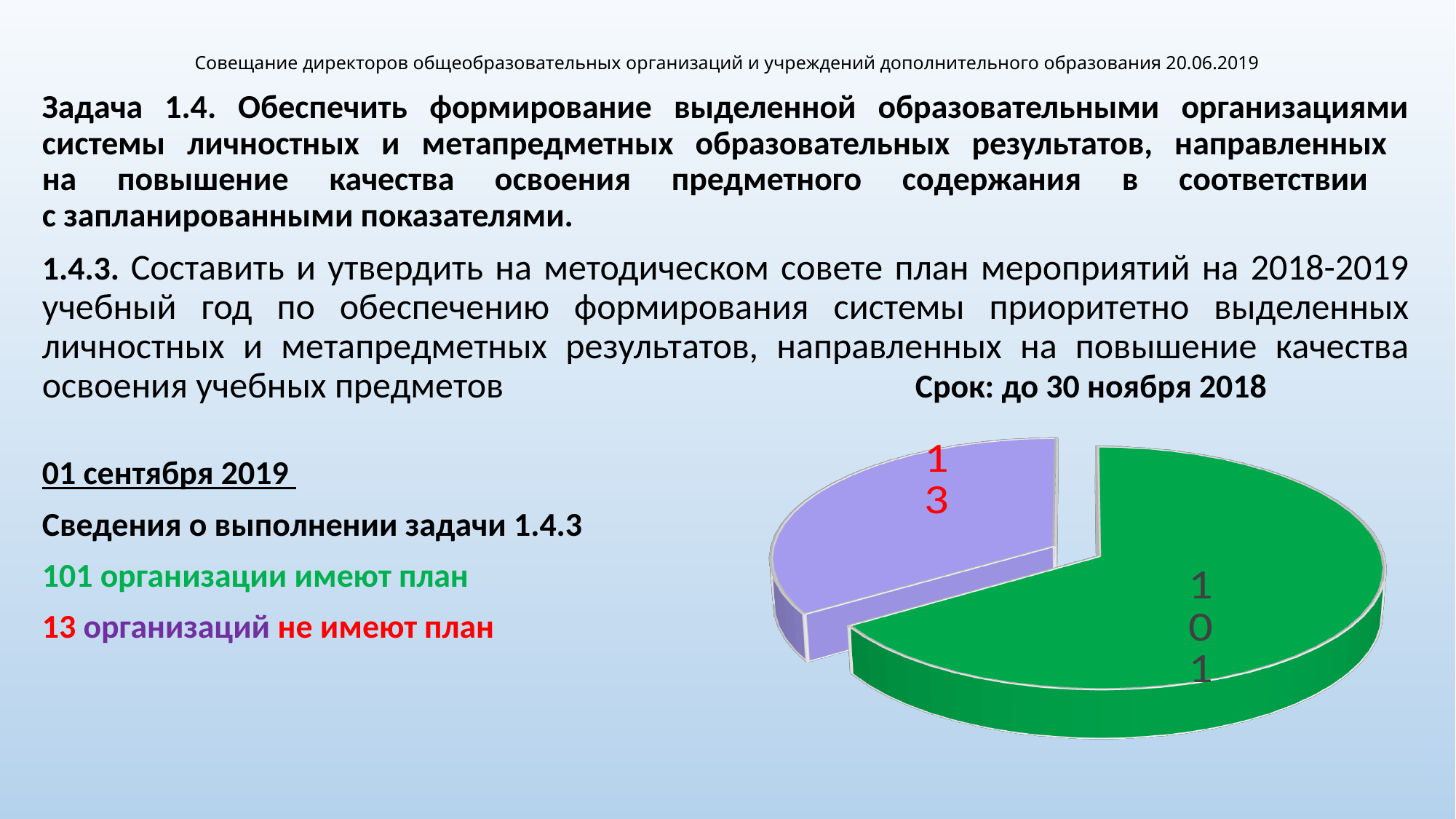
According to the slide, how many organizations do not have a plan (не имеют план)? 13 What kind of chart is shown on the slide? pie chart What is the total of the two values shown in the pie chart? 114 Which slice of the pie chart is the largest? the green slice (101) What is the difference between the two values shown in the pie chart, 101 and 13? 88 What value is printed on the green slice of the pie chart? 101 According to the slide, how many organizations have a plan (имеют план)? 101 Which is larger: the green slice or the purple slice of the pie chart? the green slice What value is printed on the purple slice of the pie chart? 13 How many slices does the pie chart have? 2 Which slice of the pie chart is the smallest? the purple slice (13) What colour is the slice representing organizations that do not have a plan? purple